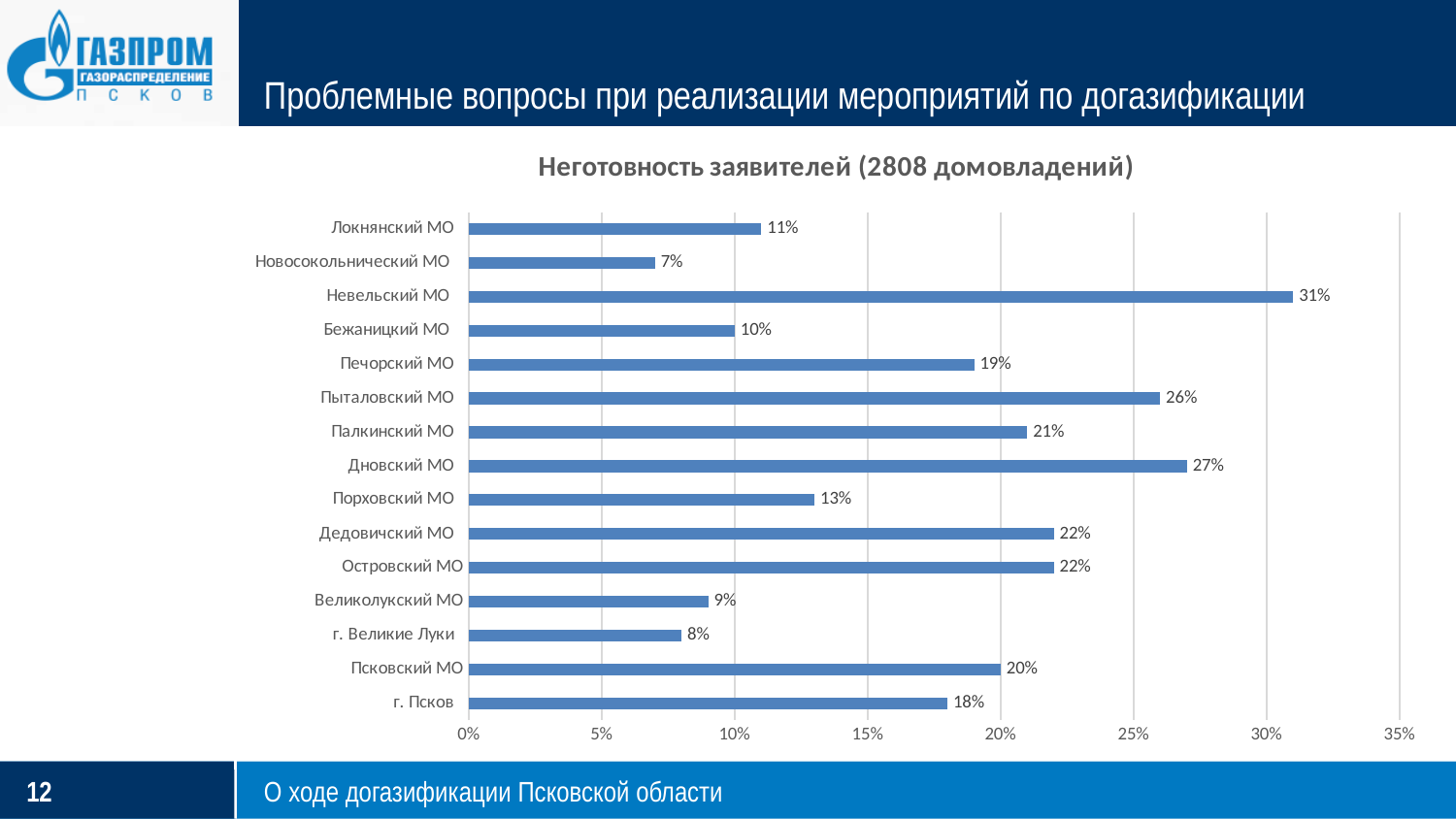
How many categories are shown in the chart? 15 What is the value for Невельский МО? 31% What is the difference between the values for Псковский МО and г. Великие Луки? 12% Which is larger, the value for Печорский МО or the value for Палкинский МО? Палкинский МО Which category has the lowest value? Новосокольнический МО What is the difference between the values for Дновский МО and Порховский МО? 14% Which category has the highest value? Невельский МО What is the value for Великолукский МО? 9% What is the value for г. Псков? 18% What is the title of the chart? Неготовность заявителей (2808 домовладений) What is the value for Пыталовский МО? 26% What kind of chart is shown on the slide? Bar chart